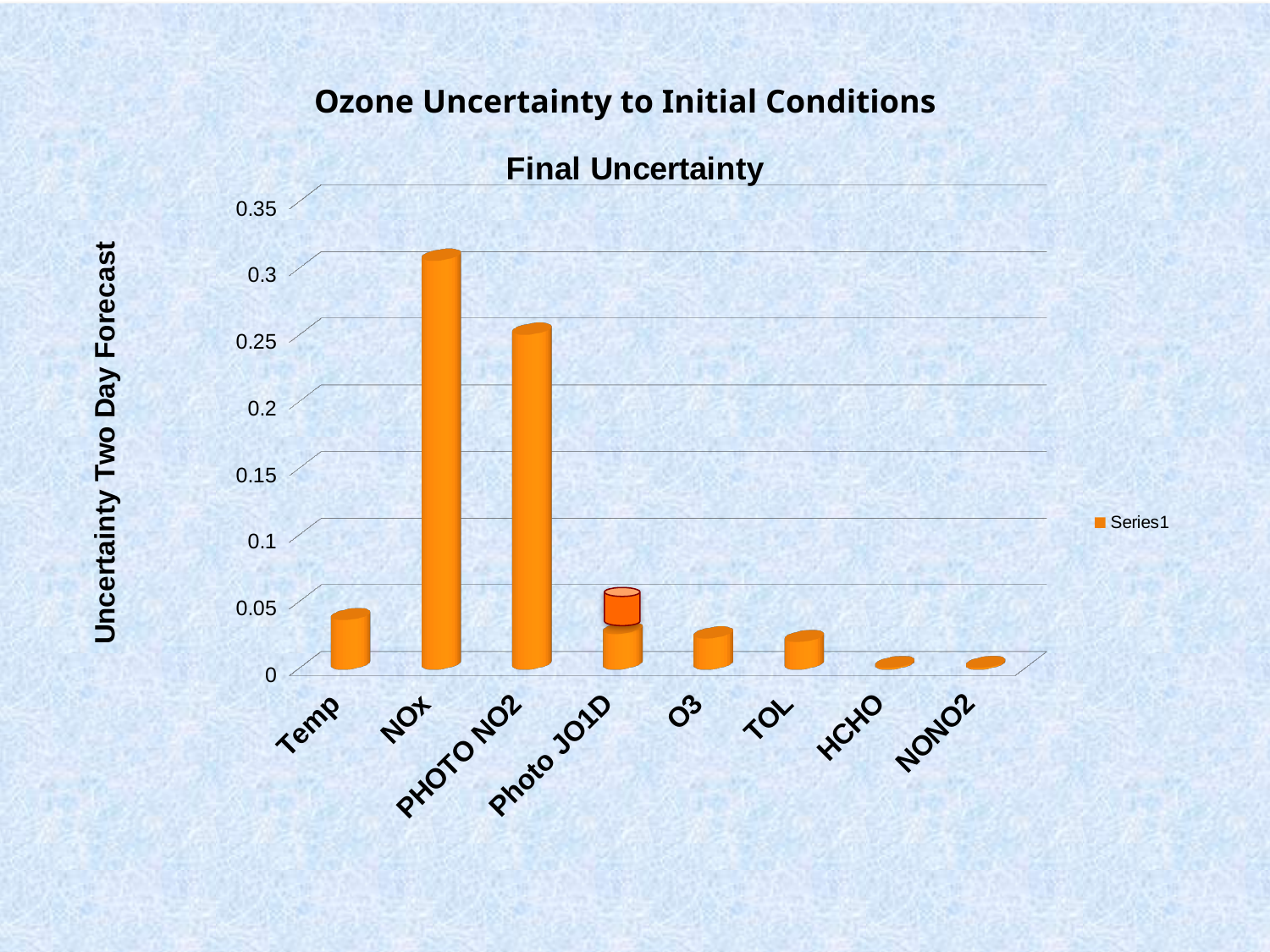
Which is larger, the value for Temp or the value for HCHO? Temp What is the title of the chart? Final Uncertainty How many series does the legend list? 1 Is the value for Temp greater or less than 0.1? less Is the value for NOx greater or less than 0.25? greater Is the value for PHOTO NO2 greater or less than 0.3? less Which is larger, the value for NOx or the value for PHOTO NO2? NOx Which category has the highest value in the chart? NOx How many categories are shown on the x axis of the chart? 8 What is the label on the vertical axis of the chart? Uncertainty Two Day Forecast What type of chart is shown on the slide? Bar chart